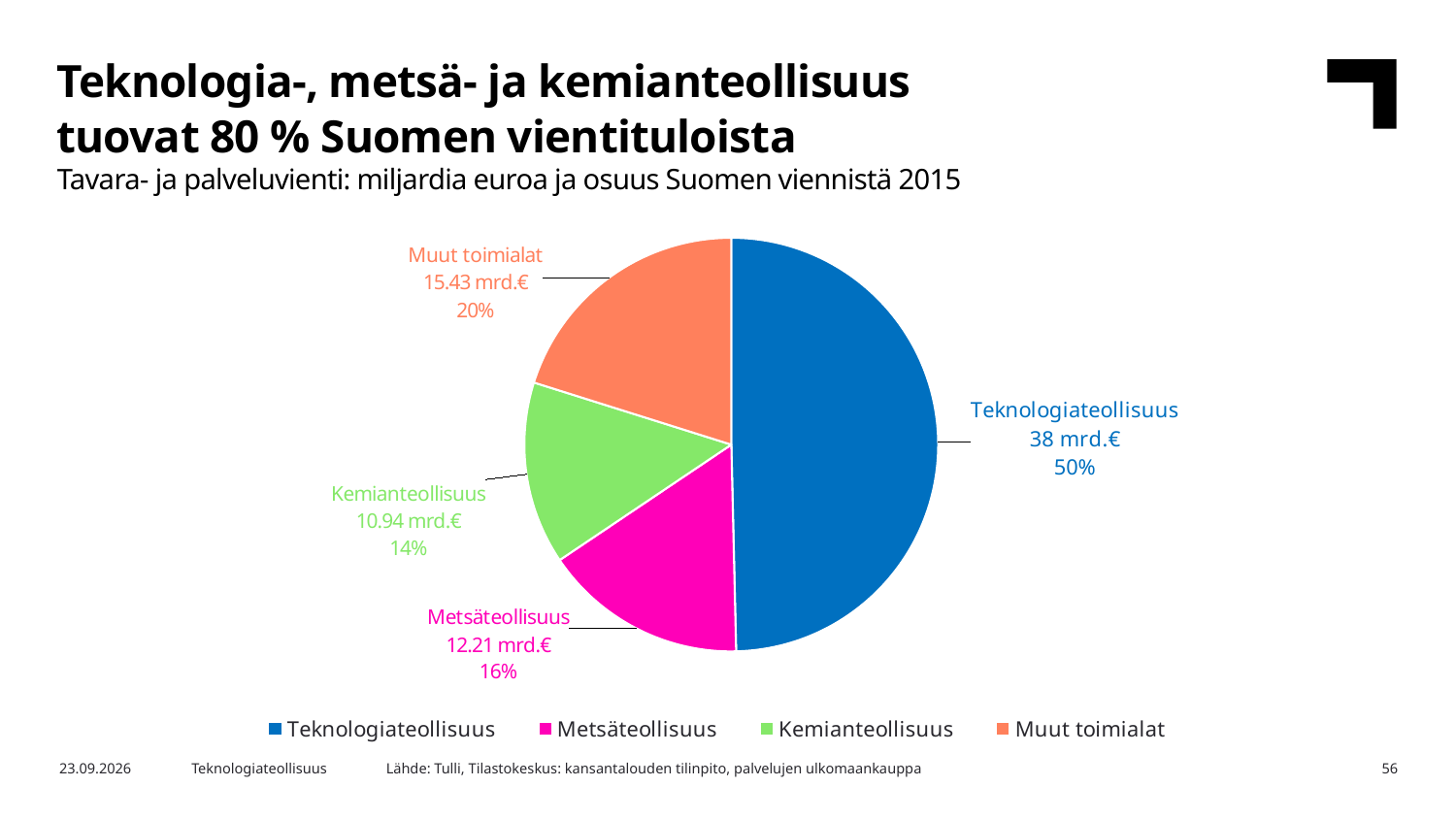
What share of the pie does Kemianteollisuus represent? 14% What kind of chart is shown on the slide? pie chart How many categories does the pie chart have? 4 Which category has the largest slice? Teknologiateollisuus What is the value for Kemianteollisuus? 10.94 mrd.€ What is the value for Teknologiateollisuus? 38 mrd.€ What is the difference between the values for Muut toimialat and Metsäteollisuus? 3.22 mrd.€ What share of the pie does Teknologiateollisuus represent? 50% What is the value for Muut toimialat? 15.43 mrd.€ Which category has the smallest slice? Kemianteollisuus What is the value for Metsäteollisuus? 12.21 mrd.€ Which is larger, the value for Metsäteollisuus or Kemianteollisuus? Metsäteollisuus